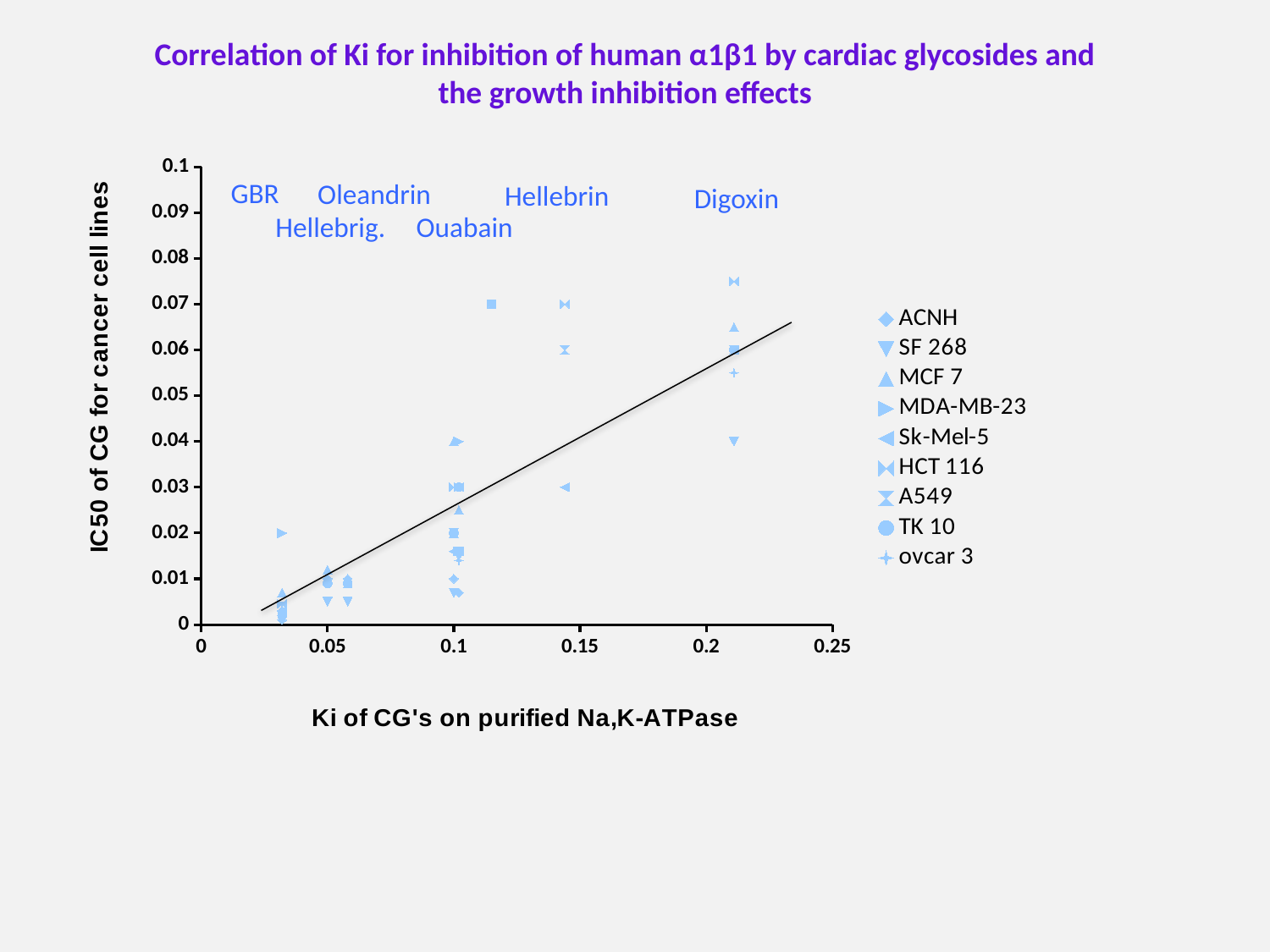
What kind of chart is shown on the slide? scatter chart Is the highest point on the chart greater or less than 0.08 on the IC50 axis? less Is the highest HCT 116 point greater or less than 0.05 on the IC50 axis? greater What is the maximum value shown on the x axis? 0.25 What is the title of the chart? Correlation of Ki for inhibition of human α1β1 by cardiac glycosides and the growth inhibition effects How many cardiac glycoside names are annotated across the top of the plot area? 6 Does the fitted trend line rise or fall as Ki increases along the x axis? rises Is the MDA-MB-23 point plotted near Ki 0.03 greater or less than 0.05 on the IC50 axis? less What is the maximum value shown on the y axis? 0.1 What is the label of the x axis? Ki of CG's on purified Na,K-ATPase How many series does the legend list? 9